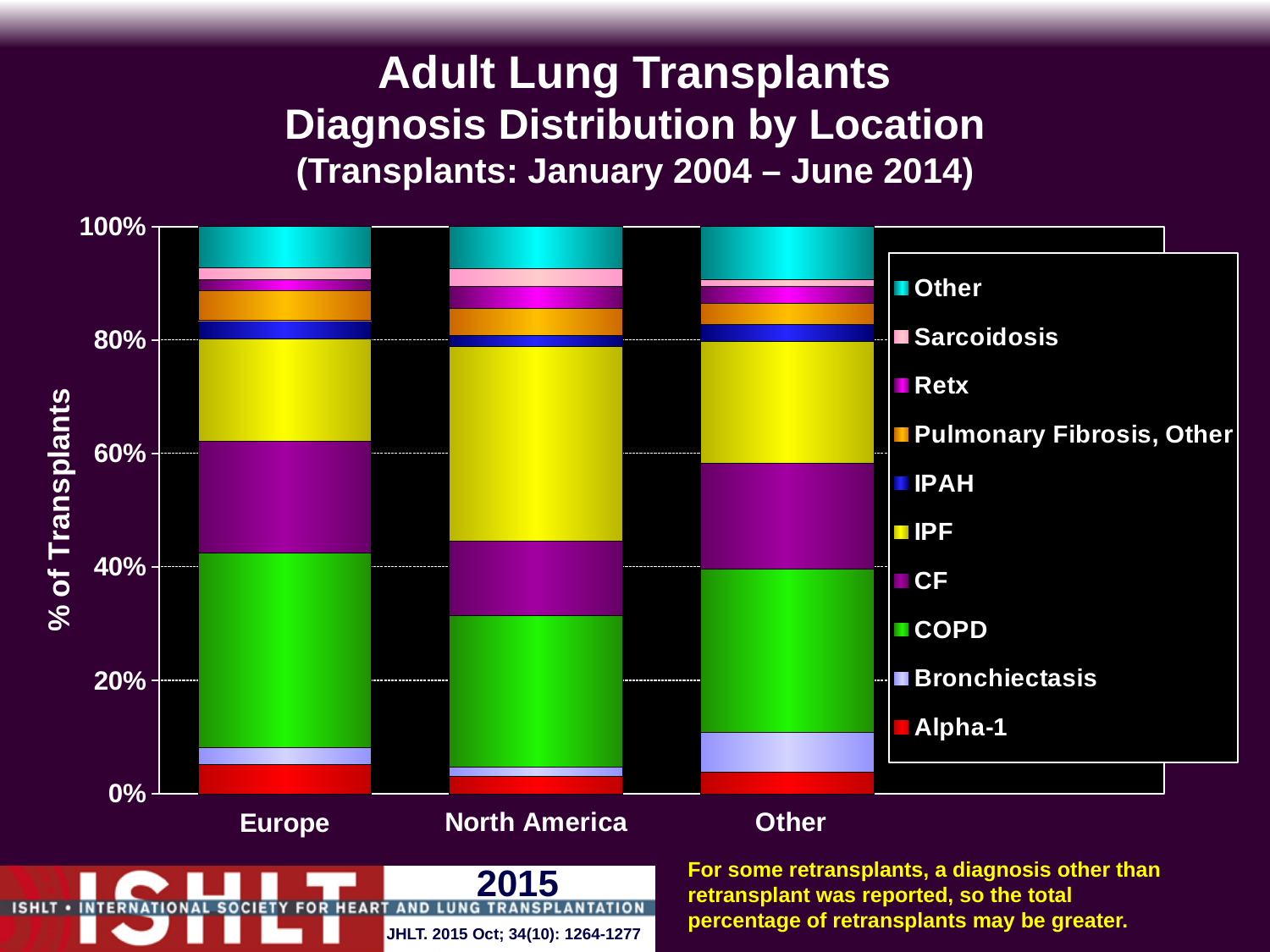
Is the top of the COPD segment for North America greater or less than 40%? less What is the label of the y axis? % of Transplants Is the top of the IPF segment for North America greater or less than 60%? greater Is the COPD segment larger for Europe or for North America? Europe Is the CF segment larger for Europe or for North America? Europe Which location has the largest Bronchiectasis segment? Other What kind of chart is shown on the slide? Stacked bar chart What transplant period is given in the chart title? January 2004 – June 2014 Which location has the largest IPF segment? North America Which location has the smallest COPD segment? North America How many diagnosis series does the legend list? 10 How many location categories are shown on the x axis? 3